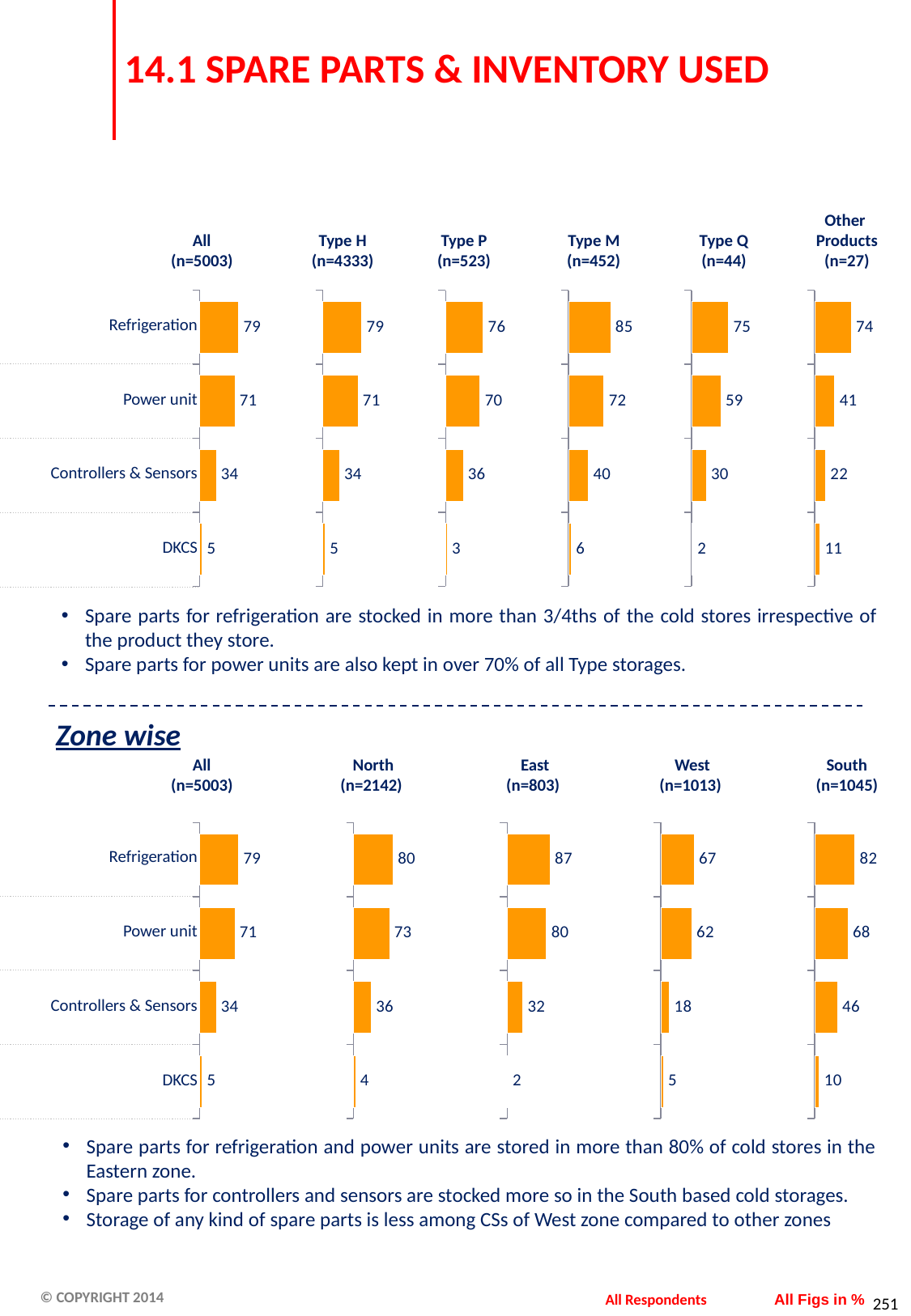
In the top set of charts (by product type), what is the value for Power unit in the Other Products (n=27) chart? 41 In the Zone wise charts, what is the difference between Refrigeration and Power unit in the East (n=803) chart? 7 In the top set of charts (by product type), how many categories are shown in each chart? 4 In the Zone wise charts, what is the value for Controllers & Sensors in the West (n=1013) chart? 18 What type of chart is used on this slide? Bar chart In the top set of charts (by product type), which category has the highest value in the All (n=5003) chart? Refrigeration In the Zone wise charts, is the Power unit value larger in the North (n=2142) chart or the South (n=1045) chart? North (n=2142) In the top set of charts (by product type), what is the difference between Refrigeration and Power unit in the Type Q (n=44) chart? 16 In the top set of charts (by product type), what is the value for Refrigeration in the Type M (n=452) chart? 85 In the Zone wise charts, what is the value for Refrigeration in the East (n=803) chart? 87 In the Zone wise charts, which zone has the highest value for Controllers & Sensors? South (n=1045) In the top set of charts (by product type), which category has the lowest value in the Type Q (n=44) chart? DKCS